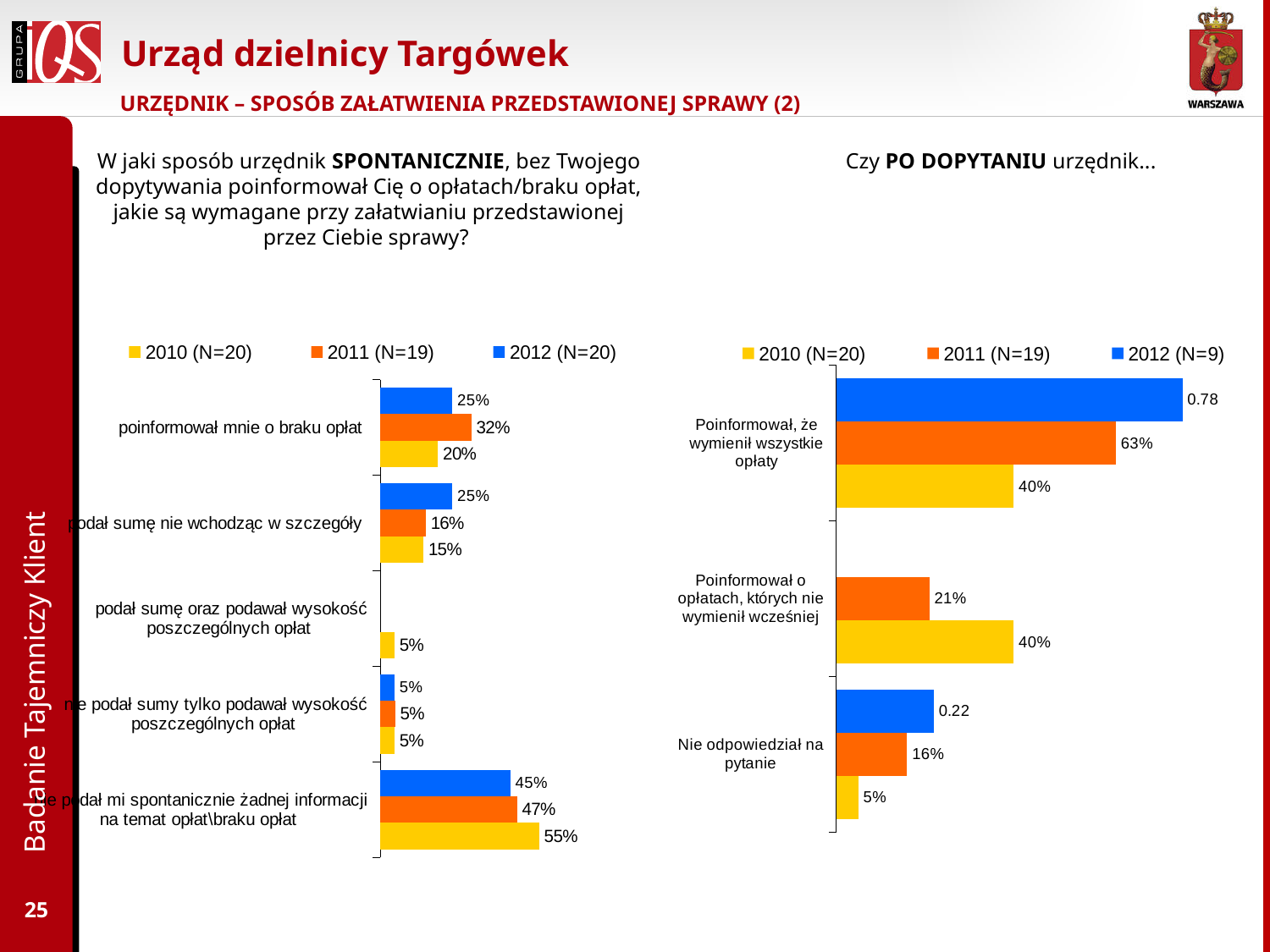
In the left chart, which category has the highest 2012 (N=20) value? nie podał mi spontanicznie żadnej informacji na temat opłat\braku opłat In the right chart, what sample size is given for 2012 in the legend? N=9 In the left chart, what is the 2010 (N=20) value for 'nie podał mi spontanicznie żadnej informacji na temat opłat\braku opłat'? 55% In the left chart, what is the difference between the 2012 and 2010 values for 'podał sumę nie wchodząc w szczegóły'? 10 percentage points In the left chart, how many series does the legend list? 3 In the right chart, what is the difference between the 2011 and 2010 values for 'Poinformował, że wymienił wszystkie opłaty'? 23 percentage points In the left chart (spontaneous information about fees), what is the 2011 (N=19) value for 'poinformował mnie o braku opłat'? 32% What type of chart is the right chart? Bar chart In the right chart, what is the 2011 (N=19) value for 'Nie odpowiedział na pytanie'? 16% In the left chart, how many categories are shown? 5 In the right chart ('Czy PO DOPYTANIU urzędnik...'), what is the 2012 (N=9) value for 'Poinformował, że wymienił wszystkie opłaty'? 0.78 In the right chart, which is larger for 'Poinformował o opłatach, których nie wymienił wcześniej': the 2010 value or the 2011 value? 2010 (40%)